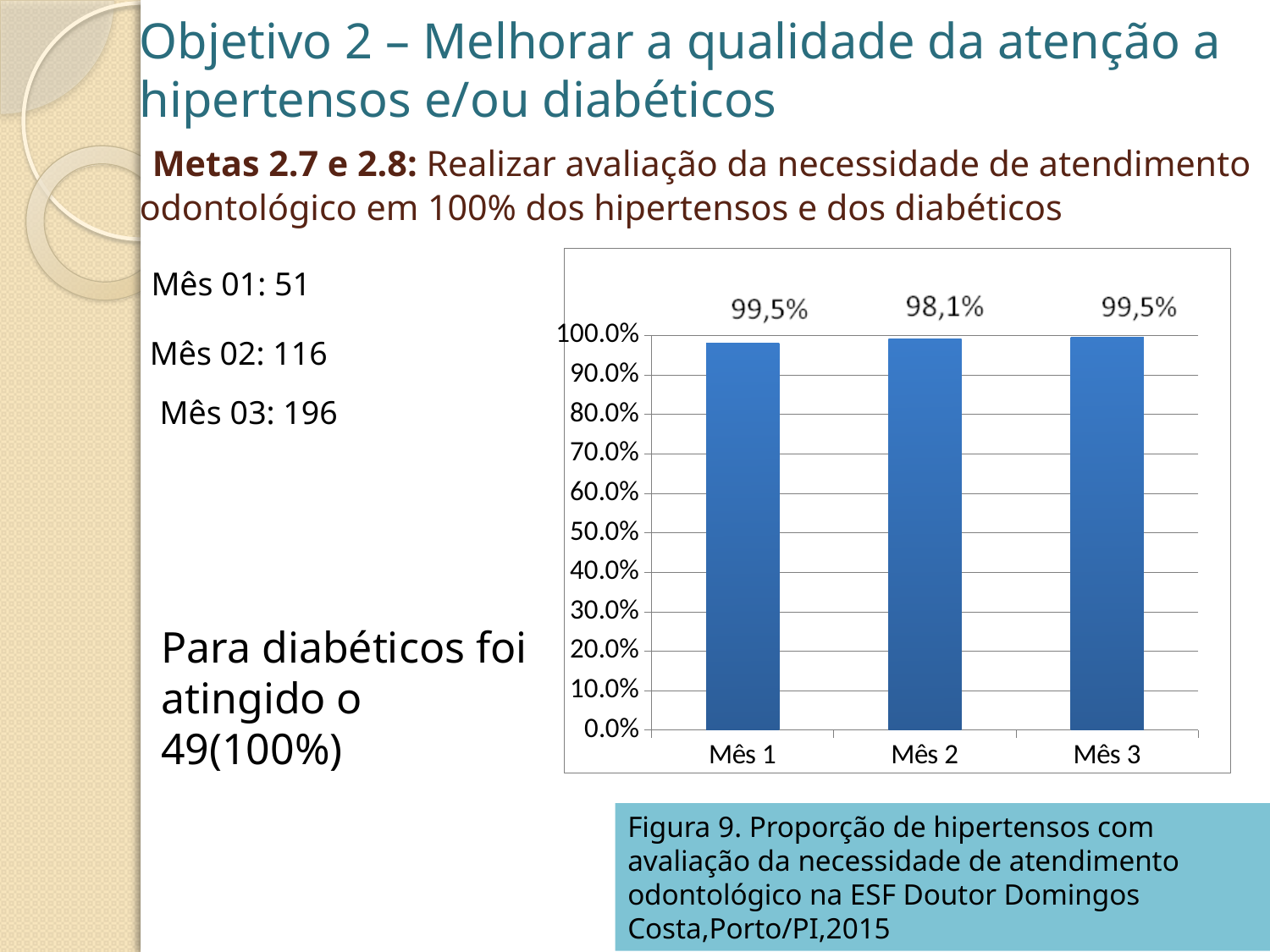
What kind of chart is shown on the slide? bar chart What is the value for Mês 3 in the chart? 99,5% How many months (categories) are shown on the x axis of the chart? 3 What is the figure number given in the caption below the chart? Figura 9 Which is larger, the value for Mês 2 or the value for Mês 3? Mês 3 What is the value for Mês 1 in the chart? 99,5% What is the value for Mês 2 in the chart? 98,1% What colour are the bars in the chart? blue Is the value for Mês 2 greater or less than 90.0%? greater